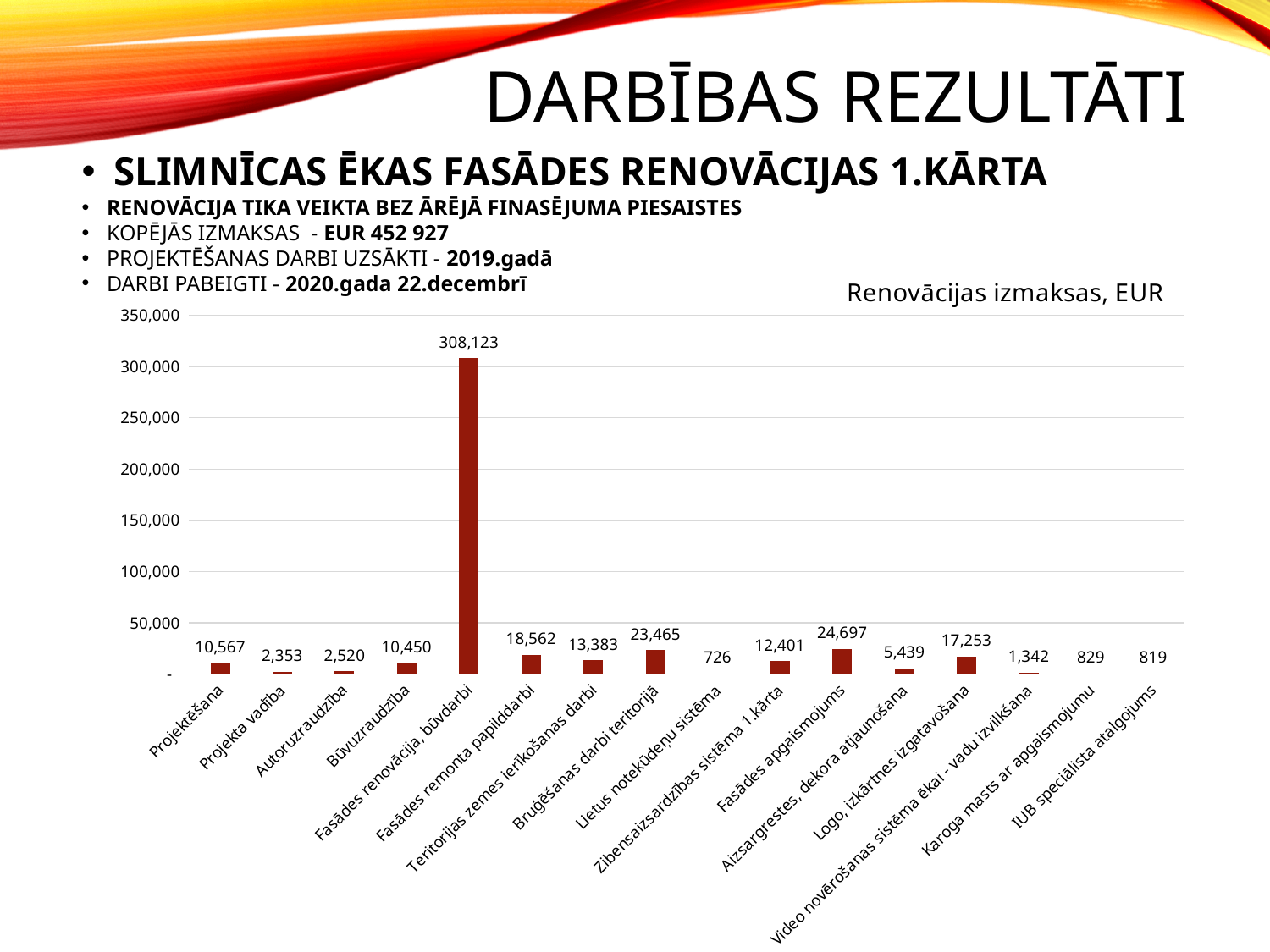
What is the difference between Projektēšana and Būvuzraudzība? 117 What is the difference between Fasādes apgaismojums and Bruģēšanas darbi teritorijā? 1,232 What is the value for Fasādes apgaismojums? 24,697 Is the value for Fasādes renovācija, būvdarbi greater or less than 300,000? greater Which category has the lowest value? Lietus notekūdeņu sistēma What is the title of the chart? Renovācijas izmaksas, EUR Which category has the highest value? Fasādes renovācija, būvdarbi What is the value for Fasādes renovācija, būvdarbi? 308,123 Which is larger, Fasādes remonta papilddarbi or Teritorijas zemes ierīkošanas darbi? Fasādes remonta papilddarbi What is the value for Lietus notekūdeņu sistēma? 726 How many categories are shown in the chart? 16 What is the value for Logo, izkārtnes izgatavošana? 17,253